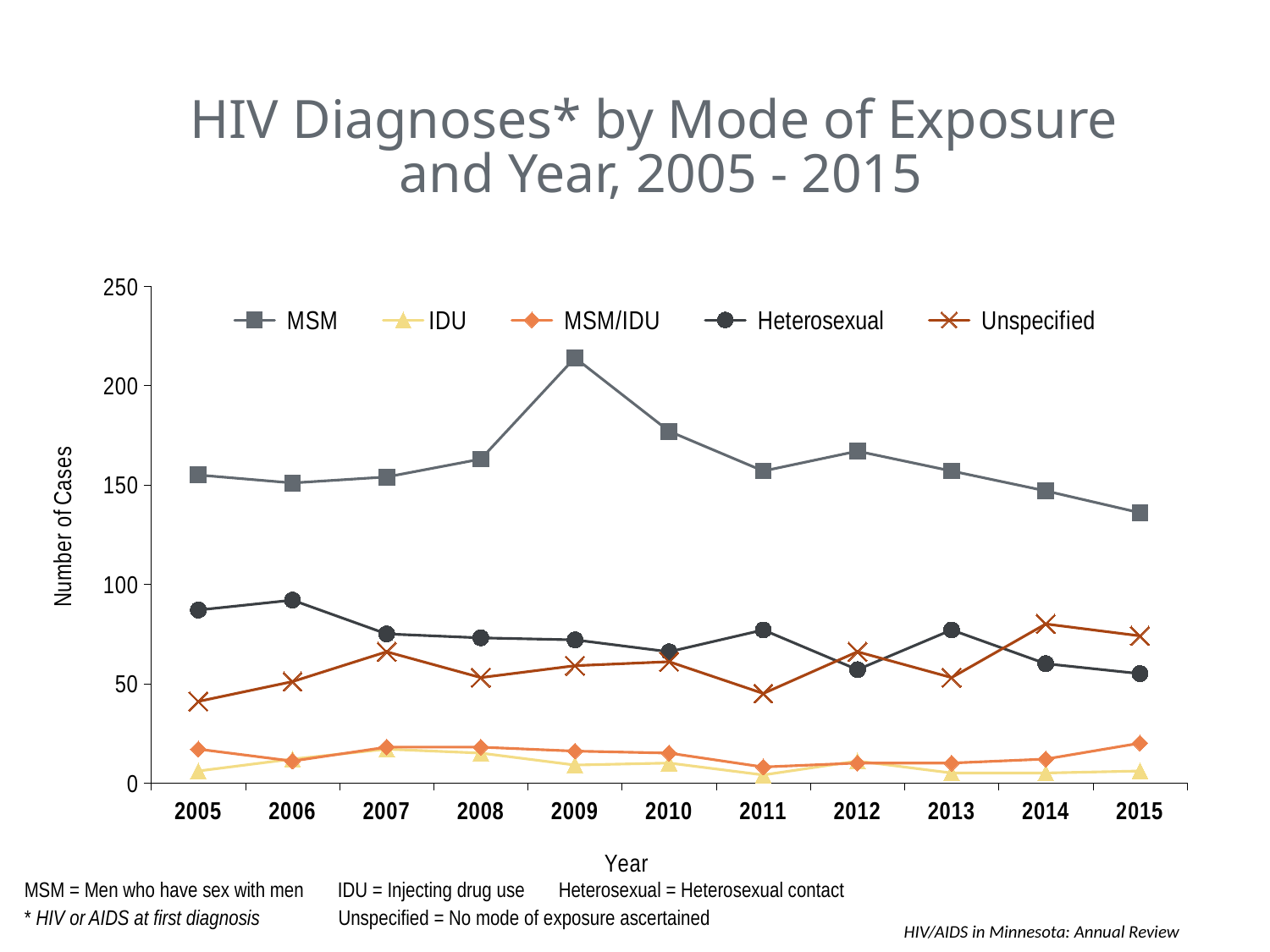
What kind of chart is shown on the slide? line chart Is the value for MSM in 2009 greater or less than 200? greater In 2014, which series has the higher value: Heterosexual or Unspecified? Unspecified In which year is the MSM series at its lowest value? 2015 How many series does the legend list? 5 Does the MSM series rise or fall from 2012 to 2015? fall How many years are plotted along the x axis? 11 Is the value for Unspecified in 2005 greater or less than 50? less In 2005, which series has the higher value: Heterosexual or Unspecified? Heterosexual In which year does the Heterosexual series reach its highest value? 2006 Is the value for MSM in 2015 greater or less than 150? less In which year does the MSM series reach its highest value? 2009